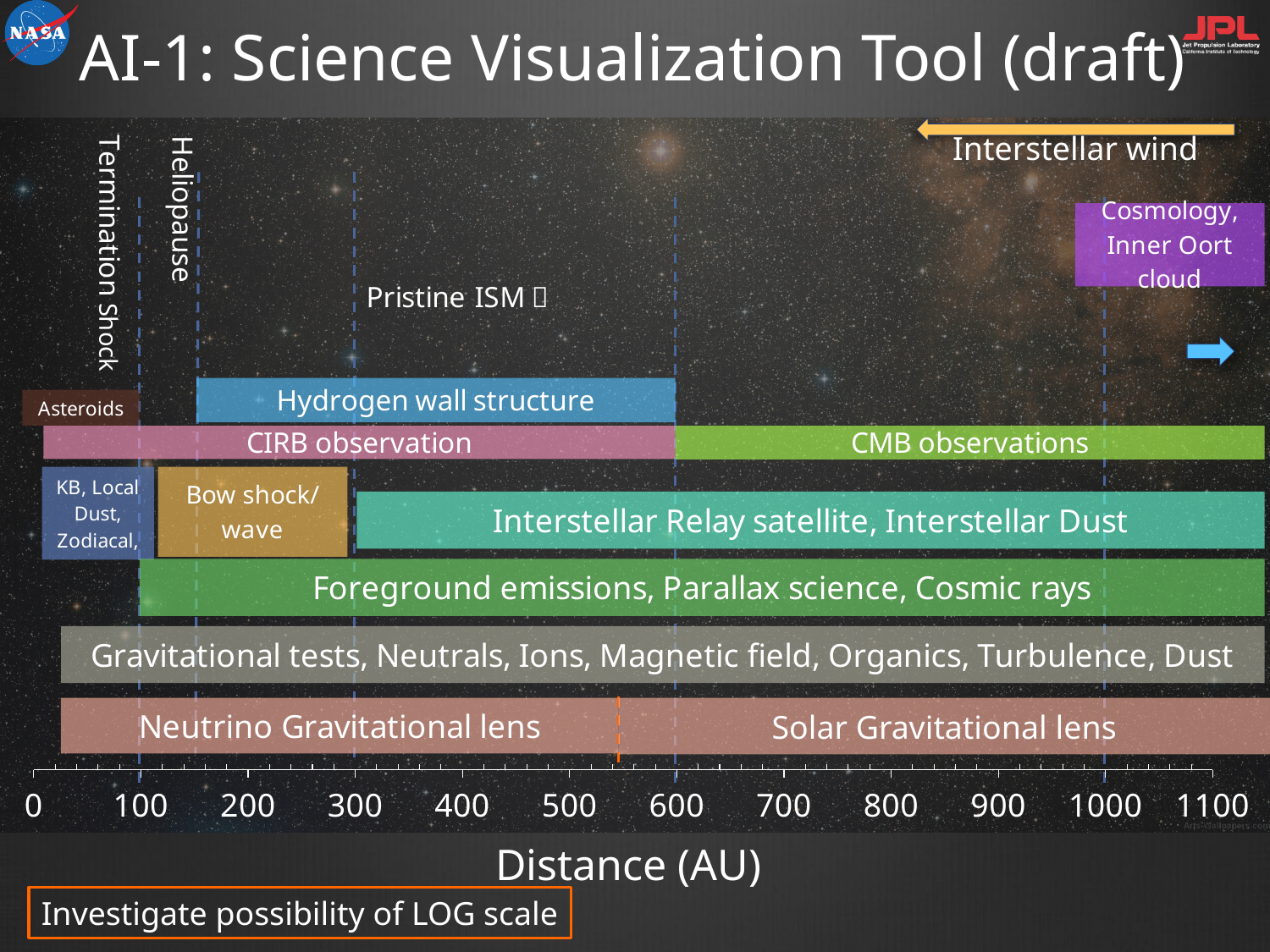
What is the largest value printed on the distance axis? 1100 What is the label of the horizontal axis at the bottom of the diagram? Distance (AU) At what distance does the Solar Gravitational lens bar end? 1000 Is the starting distance of the Bow shock/wave bar greater or less than 200? less At what distance on the axis is the Termination Shock dashed line drawn? 100 Which bar starts farther to the left on the distance axis, Asteroids or Bow shock/wave? Asteroids At what distance does the Hydrogen wall structure bar end? 600 Which bar extends farther to the right along the distance axis, Hydrogen wall structure or Interstellar Relay satellite, Interstellar Dust? Interstellar Relay satellite, Interstellar Dust At what distance does the Interstellar Relay satellite, Interstellar Dust bar begin? 300 Is the ending distance of the Neutrino Gravitational lens bar greater or less than 500? greater What does the orange-outlined note at the bottom of the slide say? Investigate possibility of LOG scale At what distance does the CMB observations bar begin? 600